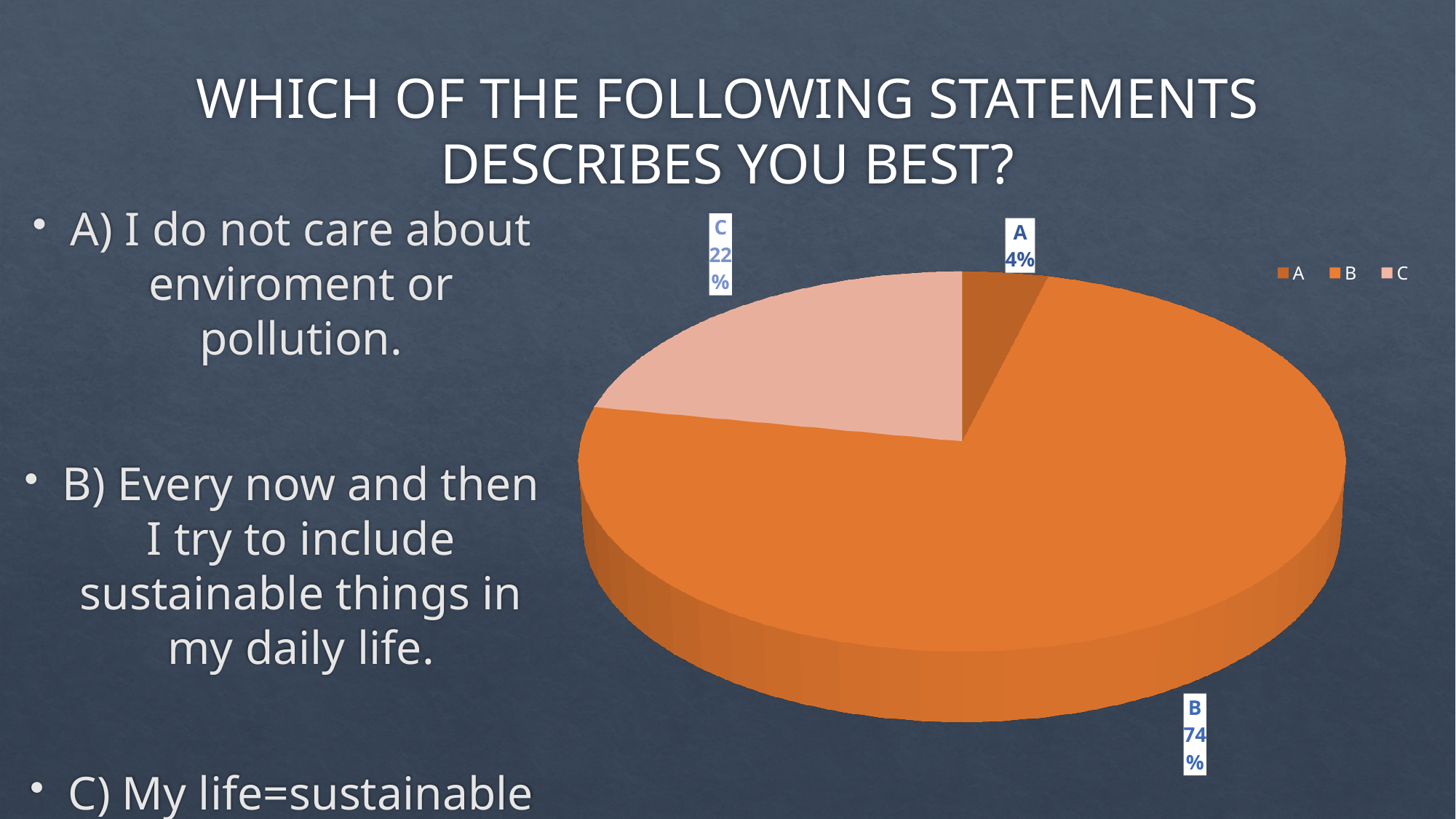
What percentage of the pie does slice A represent? 4% What percentage of the pie does slice B represent? 74% What are the legend entries of the pie chart? A, B, C What is the difference in percentage points between slice C and slice A? 18 What is the difference in percentage points between slice B and slice C? 52 How many entries does the legend list? 3 How many slices does the pie chart have? 3 Which slice is the largest in the pie chart? B Which is larger, slice C or slice A? C Which slice is the smallest in the pie chart? A What kind of chart is shown on the slide? pie chart What percentage of the pie does slice C represent? 22%